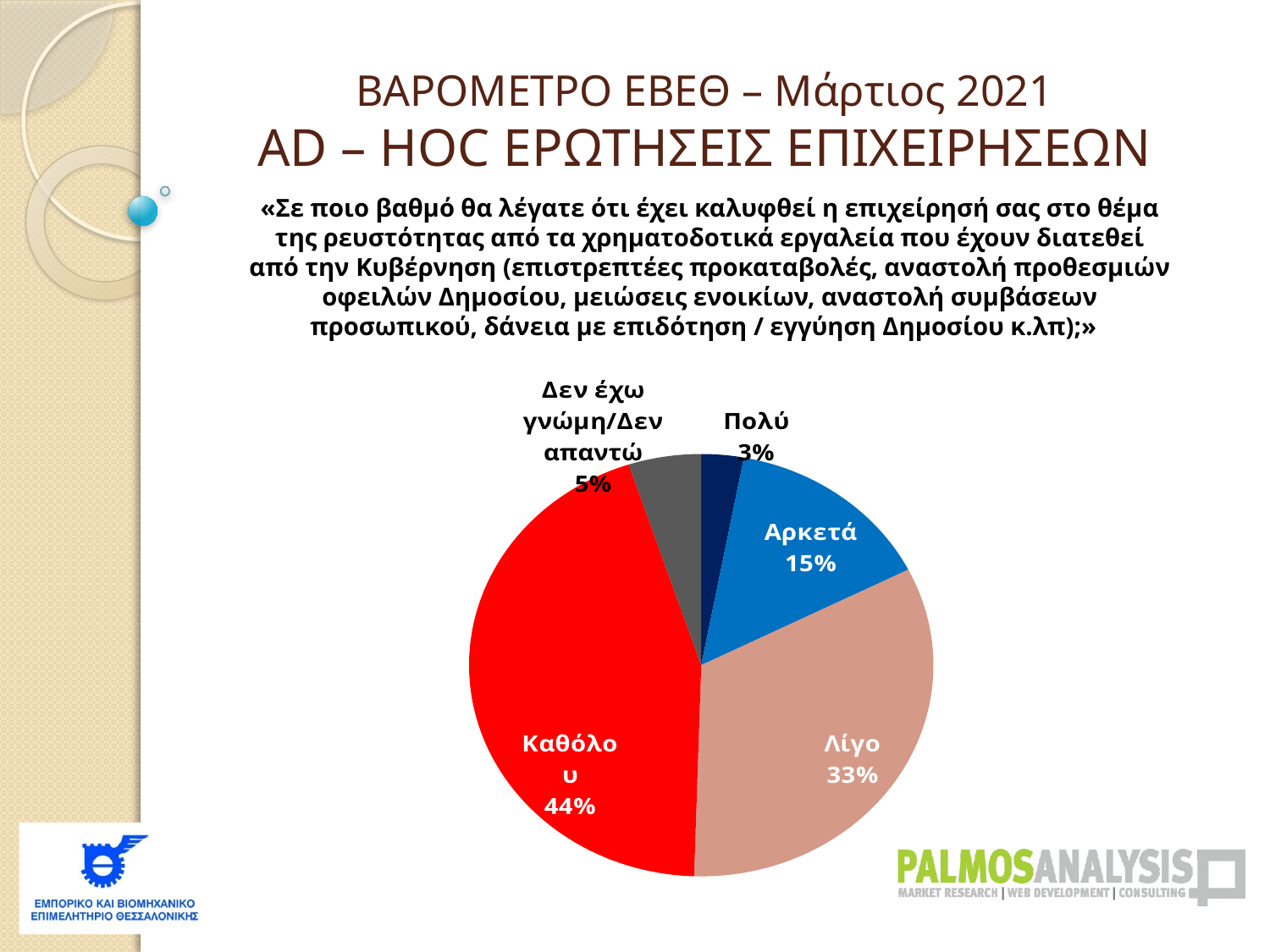
What percentage of the pie is labelled Πολύ? 3% Which category has the smallest share of the pie? Πολύ What percentage of the pie is labelled Αρκετά? 15% What type of chart is shown on the slide? pie chart What colour is the Καθόλου slice? red How many slices does the pie chart have? 5 Which is larger, the share for Αρκετά or the share for Δεν έχω γνώμη/Δεν απαντώ? Αρκετά What is the difference in percentage points between Καθόλου and Λίγο? 11 What percentage of the pie is labelled Λίγο? 33% Which category has the largest share of the pie? Καθόλου What percentage of the pie is labelled Δεν έχω γνώμη/Δεν απαντώ? 5% What percentage of the pie is labelled Καθόλου? 44%